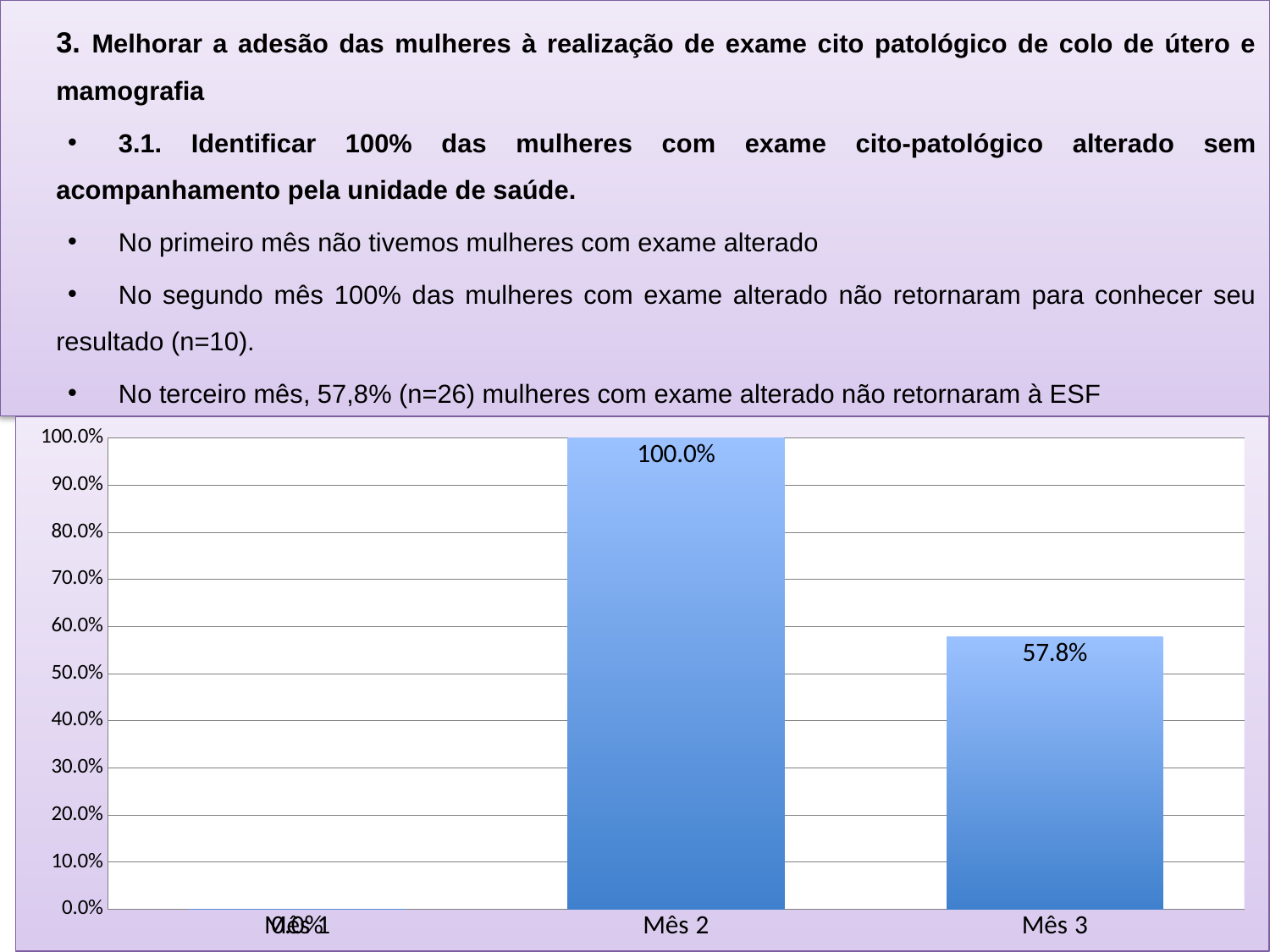
How many categories are shown on the x axis? 3 What is the difference between the values for Mês 2 and Mês 3? 42.2% What is the value for Mês 3? 57.8% What is the value for Mês 2? 100.0% What is the highest value shown on the y axis? 100.0% Is the value for Mês 3 greater or less than 60.0%? less Which month has the highest value? Mês 2 Does the value rise or fall from Mês 2 to Mês 3? fall What kind of chart is shown on the slide? bar chart Which is larger, the value for Mês 2 or the value for Mês 3? Mês 2 Is the value for Mês 3 greater or less than 50.0%? greater Which month has the lowest value? Mês 1